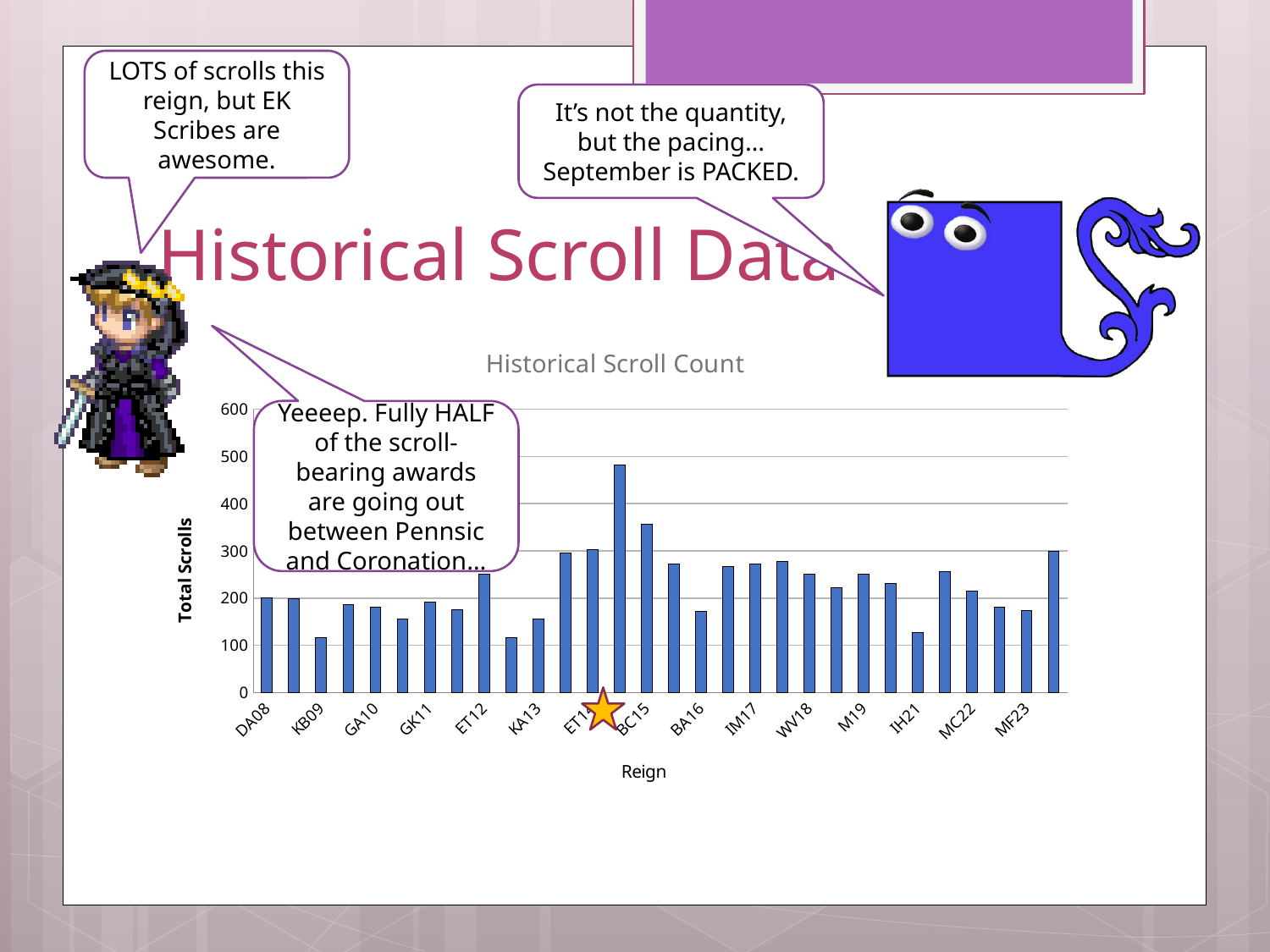
Is the value for BC15 greater or less than 300? greater What kind of chart is shown on the slide? Bar chart What is the label on the vertical axis of the chart? Total Scrolls Is the value for BA16 greater or less than 200? less Is the value for IH21 greater or less than 200? less Which has the lower total scrolls, IH21 or BC15? IH21 What is the title of the chart? Historical Scroll Count Which has the higher total scrolls, BC15 or KB09? BC15 Which has the higher total scrolls, ET12 or BA16? ET12